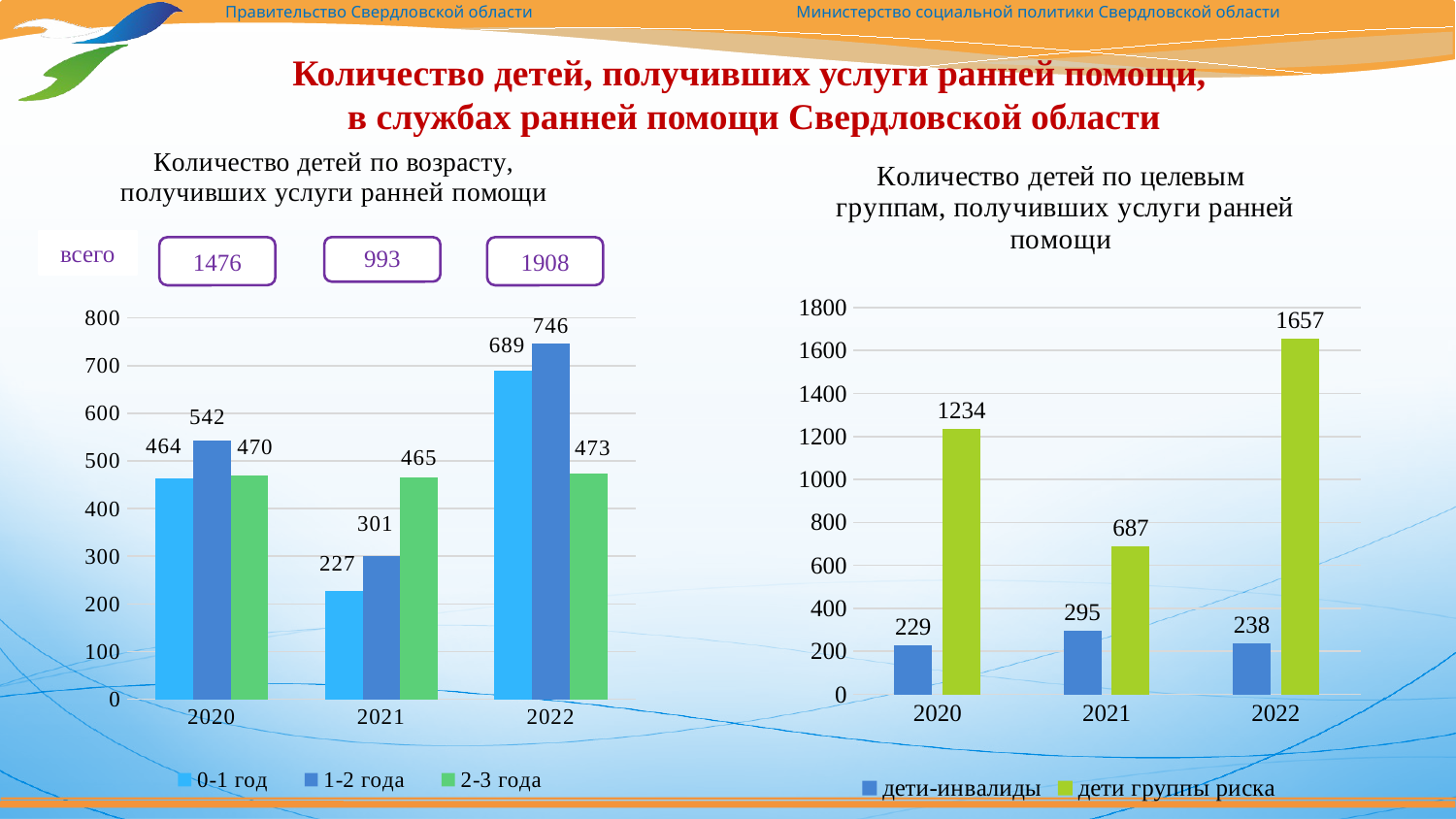
In the left chart (Количество детей по возрасту), what is the value for 0-1 год in 2021? 227 In the left chart (Количество детей по возрасту), what is the difference between the 1-2 года and 0-1 год values in 2022? 57 In the left chart (Количество детей по возрасту), what is the value for 1-2 года in 2020? 542 In the left chart (Количество детей по возрасту), which year has the highest value for 2-3 года? 2022 In the left chart (Количество детей по возрасту), what is the total (всего) shown for 2021? 993 In the right chart (Количество детей по целевым группам), what is the difference between дети группы риска and дети-инвалиды in 2022? 1419 In the right chart (Количество детей по целевым группам), how many years are shown on the x axis? 3 In the right chart (Количество детей по целевым группам), what is the value for дети группы риска in 2021? 687 In the right chart (Количество детей по целевым группам), which is larger: дети группы риска in 2020 or дети группы риска in 2021? дети группы риска in 2020 In the right chart (Количество детей по целевым группам), which year has the lowest value for дети-инвалиды? 2020 In the left chart (Количество детей по возрасту), how many series does the legend list? 3 What type of chart is the right chart (Количество детей по целевым группам)? bar chart